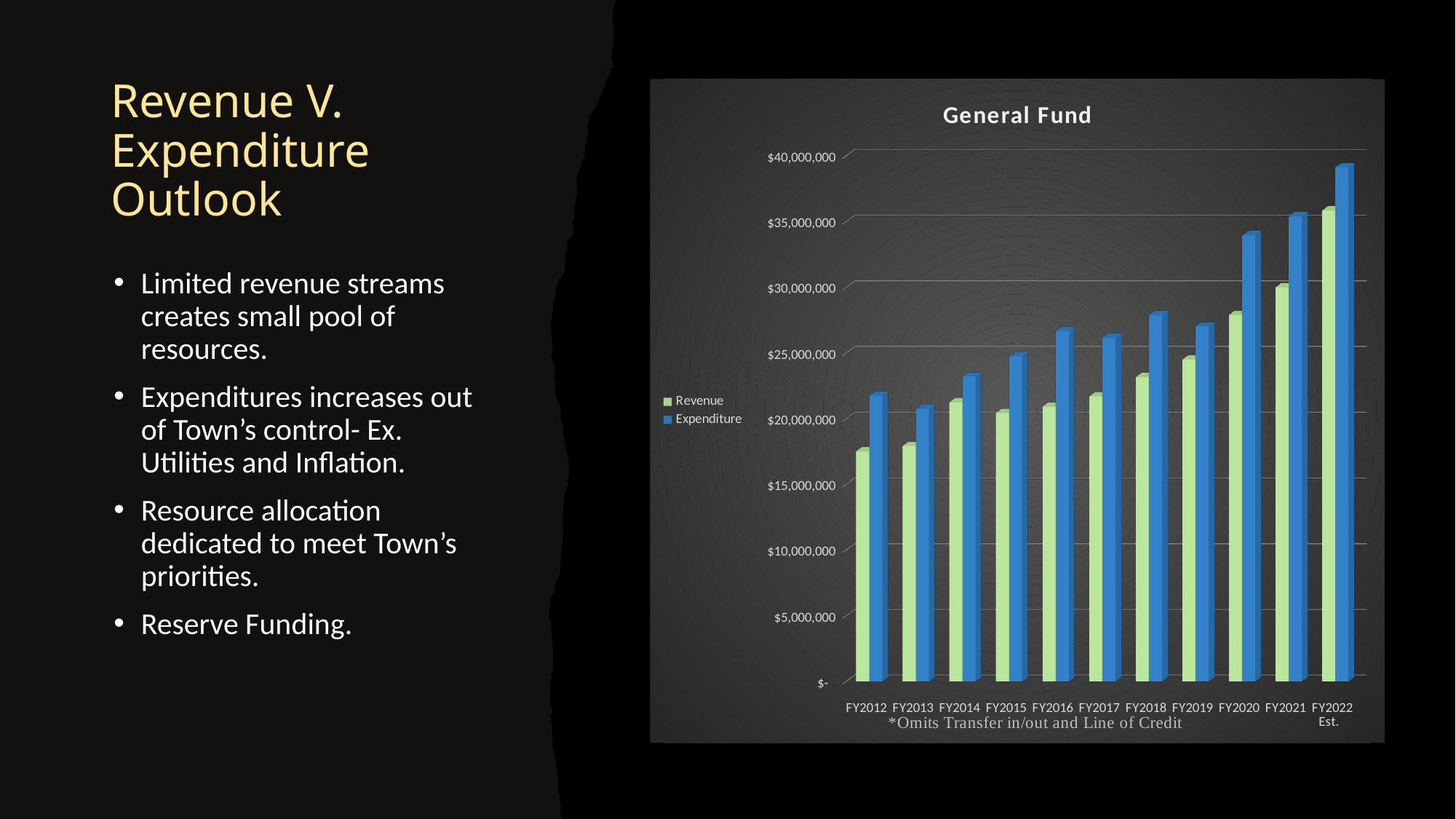
How many series does the chart's legend list? 2 What is the title of the chart? General Fund Is the Expenditure value for FY2022 Est. greater or less than $35,000,000? greater What kind of chart is shown on the slide? bar chart Does Revenue generally rise or fall from FY2012 to FY2022 Est.? rise For FY2022 Est., which is larger, Revenue or Expenditure? Expenditure Is the Expenditure value for FY2016 greater or less than $25,000,000? greater In which fiscal year is Expenditure highest? FY2022 Est. Is the Revenue value for FY2020 greater or less than $30,000,000? less In which fiscal year is Revenue lowest? FY2012 How many fiscal years are shown on the x axis of the chart? 11